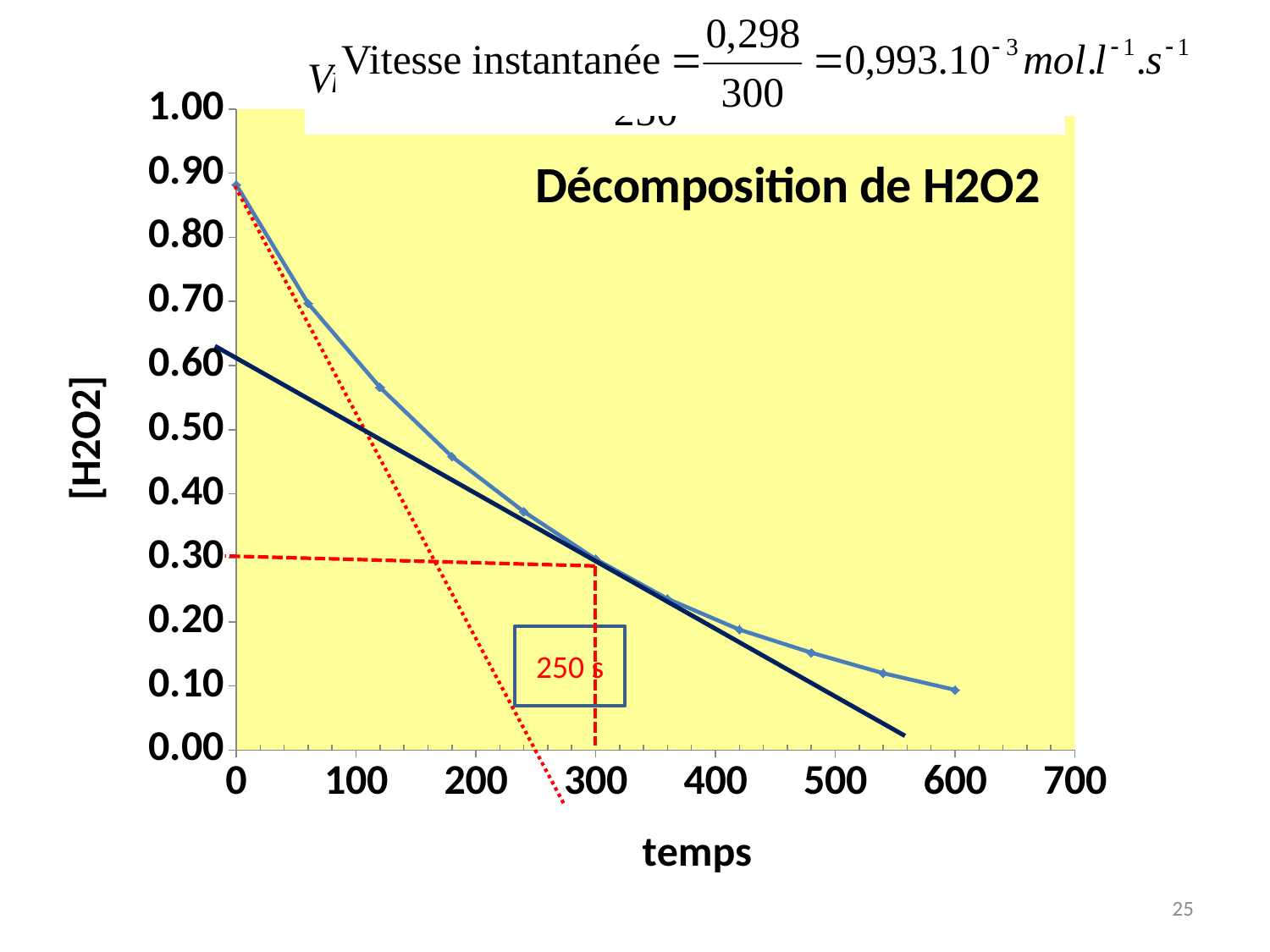
Is the value of [H2O2] at temps = 60 greater or less than 0.80? less At which value of temps is [H2O2] highest? 0 What kind of chart is shown on the slide? line chart At which value of temps is [H2O2] lowest? 600 Which is larger, the value of [H2O2] at temps = 120 or at temps = 360? temps = 120 What is the title of the chart? Décomposition de H2O2 Is the value of [H2O2] at temps = 120 greater or less than 0.50? greater Is the value of [H2O2] at temps = 0 greater or less than 0.80? greater How many data points are plotted on the [H2O2] curve? 11 Does the plotted [H2O2] curve rise or fall as temps increases? fall What is the label of the y axis of the chart? [H2O2]